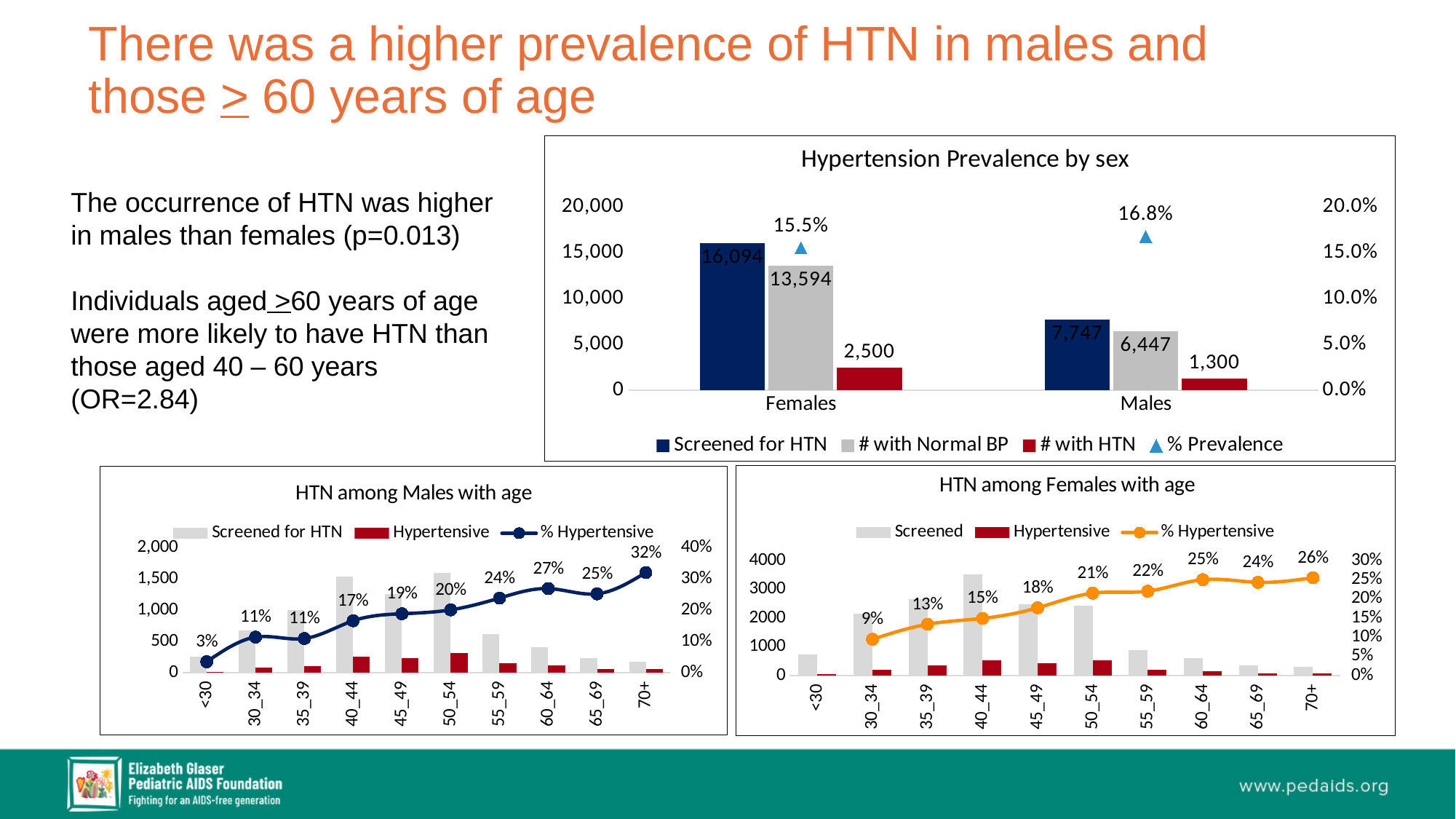
In the 'HTN among Males with age' chart, what is the % Hypertensive for the 70+ age group? 32% How many series does the legend of the 'Hypertension Prevalence by sex' chart list? 4 In the 'Hypertension Prevalence by sex' chart, what is the number of males with HTN? 1,300 In the 'Hypertension Prevalence by sex' chart, which sex has the higher % Prevalence? Males In the 'Hypertension Prevalence by sex' chart, how many females were screened for HTN? 16,094 In the 'HTN among Males with age' chart, what is the difference in % Hypertensive between the 70+ and 65_69 age groups? 7% In the 'HTN among Females with age' chart, what is the % Hypertensive for the 50_54 age group? 21% In the 'HTN among Males with age' chart, which age group has the lowest % Hypertensive? <30 In the 'HTN among Females with age' chart, is the number Screened for the 40_44 age group greater or less than 3000? greater In the 'Hypertension Prevalence by sex' chart, what is the difference between the number of females with HTN and the number of males with HTN? 1,200 In the 'Hypertension Prevalence by sex' chart, what is the % Prevalence for males? 16.8% How many age groups are shown on the x axis of the 'HTN among Females with age' chart? 10